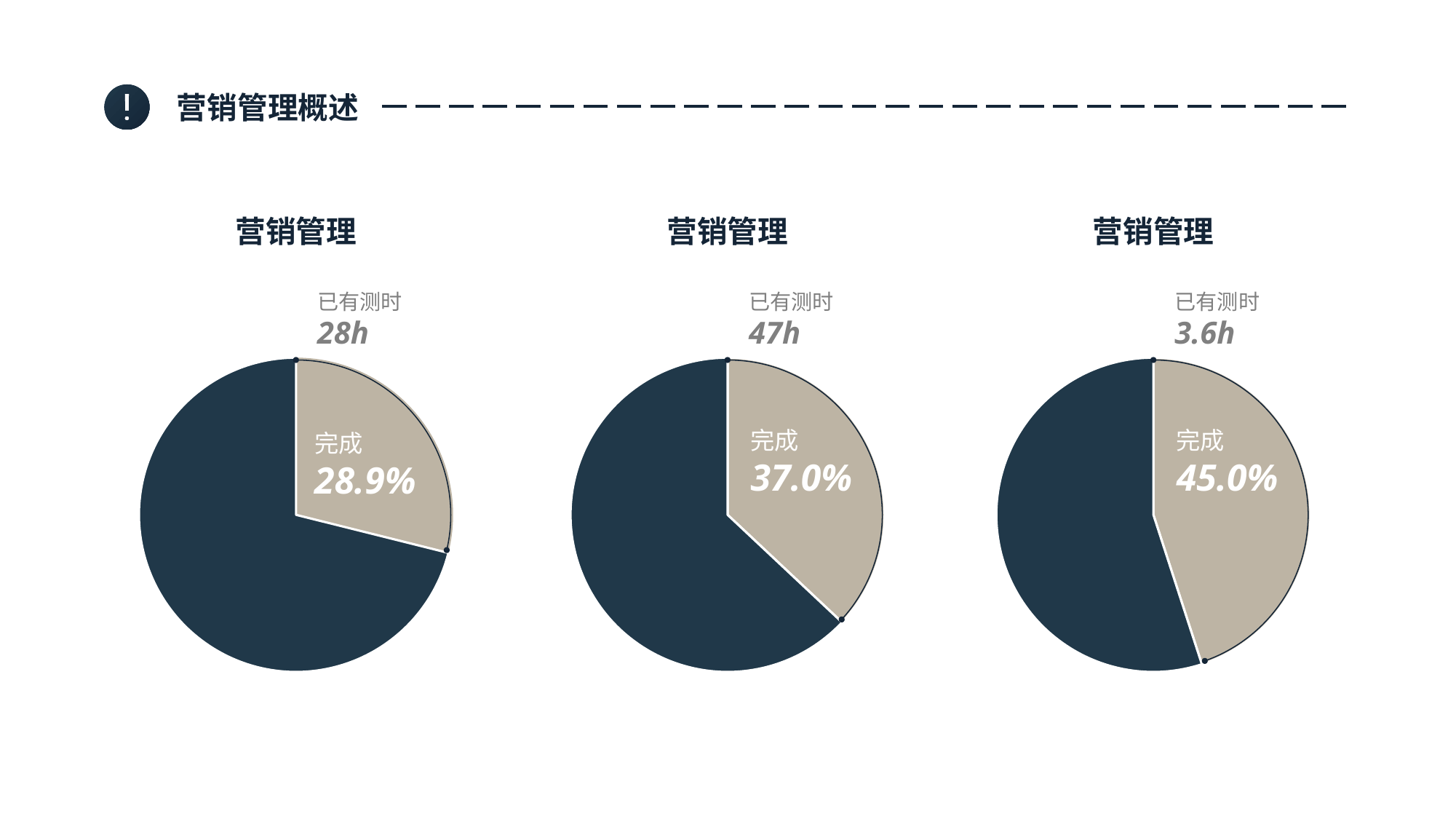
In the right pie chart, what value is given for 已有测时? 3.6h What kind of chart is used for the three charts on the slide? Pie chart In the left pie chart, what percentage is shown for 完成? 28.9% In the right pie chart, what percentage is shown for 完成? 45.0% In the middle pie chart, what percentage is shown for 完成? 37.0% In the left pie chart, what value is given for 已有测时? 28h How many slices does the left pie chart have? 2 Which of the three pie charts shows the highest 完成 percentage? The right pie chart (45.0%) In the middle pie chart, what value is given for 已有测时? 47h Which of the three pie charts shows the lowest 完成 percentage? The left pie chart (28.9%) What is the difference between the 完成 percentage in the right pie chart and the left pie chart? 16.1 percentage points Is the 完成 percentage in the middle pie chart larger or smaller than in the right pie chart? Smaller